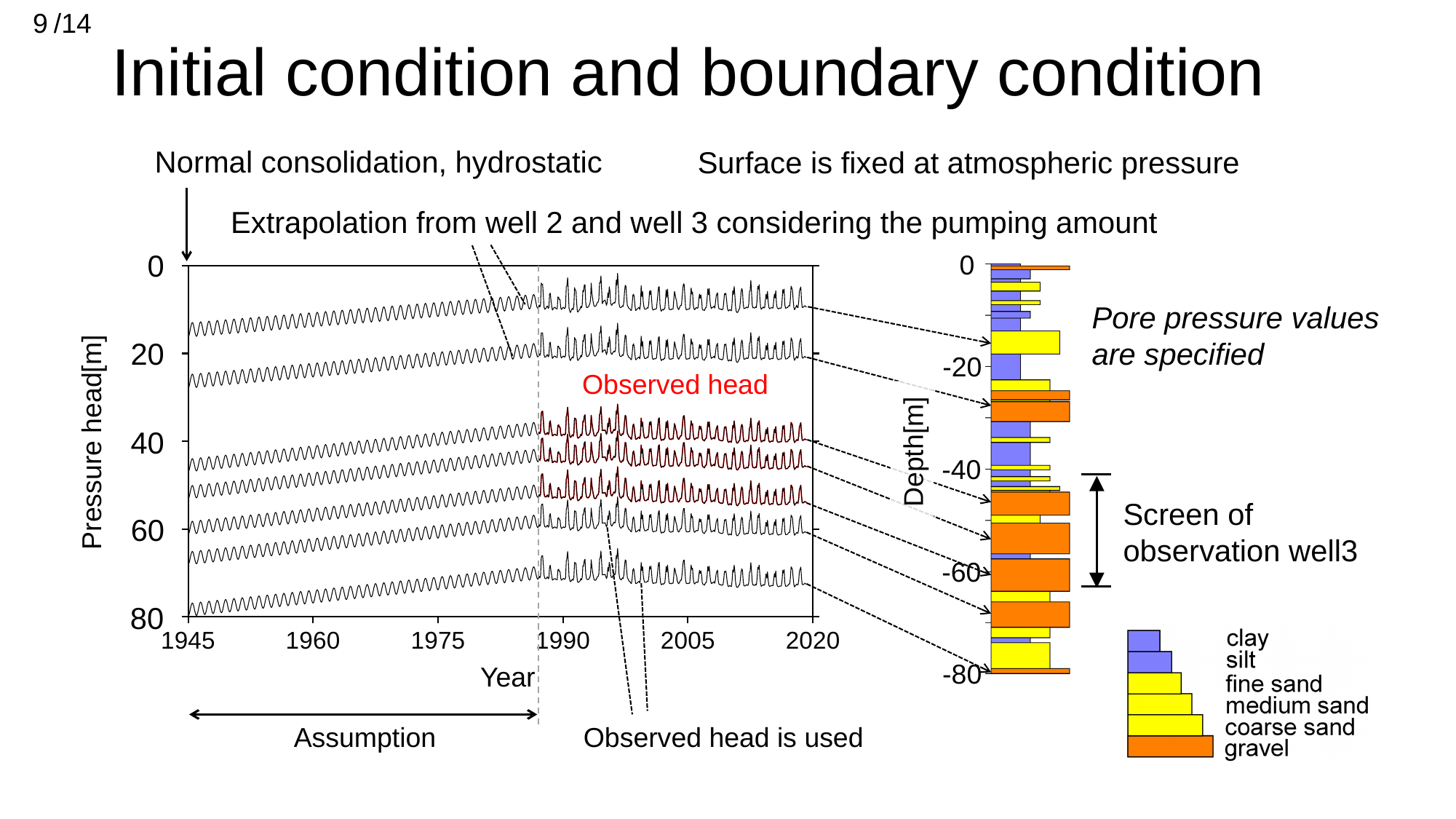
In the pressure head chart, what is the first year shown on the x axis? 1945 In the pressure head chart, what is the last year shown on the x axis? 2020 In the pressure head chart, what is the label of the y axis? Pressure head[m] In the depth column on the right, what is the lowest depth value shown on the axis? -80 In the pressure head chart, is the value of the lowest line at 1945 greater or less than 60? greater In the pressure head chart, what is the label of the x axis? Year What kind of chart is the plot of pressure head against year on the left of the slide? line chart In the pressure head chart, what is the largest value shown on the y axis? 80 How many soil types does the legend of the depth column on the right list? 6 In the pressure head chart, do the plotted pressure head values increase or decrease from 1945 to 2020? decrease In the pressure head chart, is the value of the topmost line at 2020 greater or less than 20? less